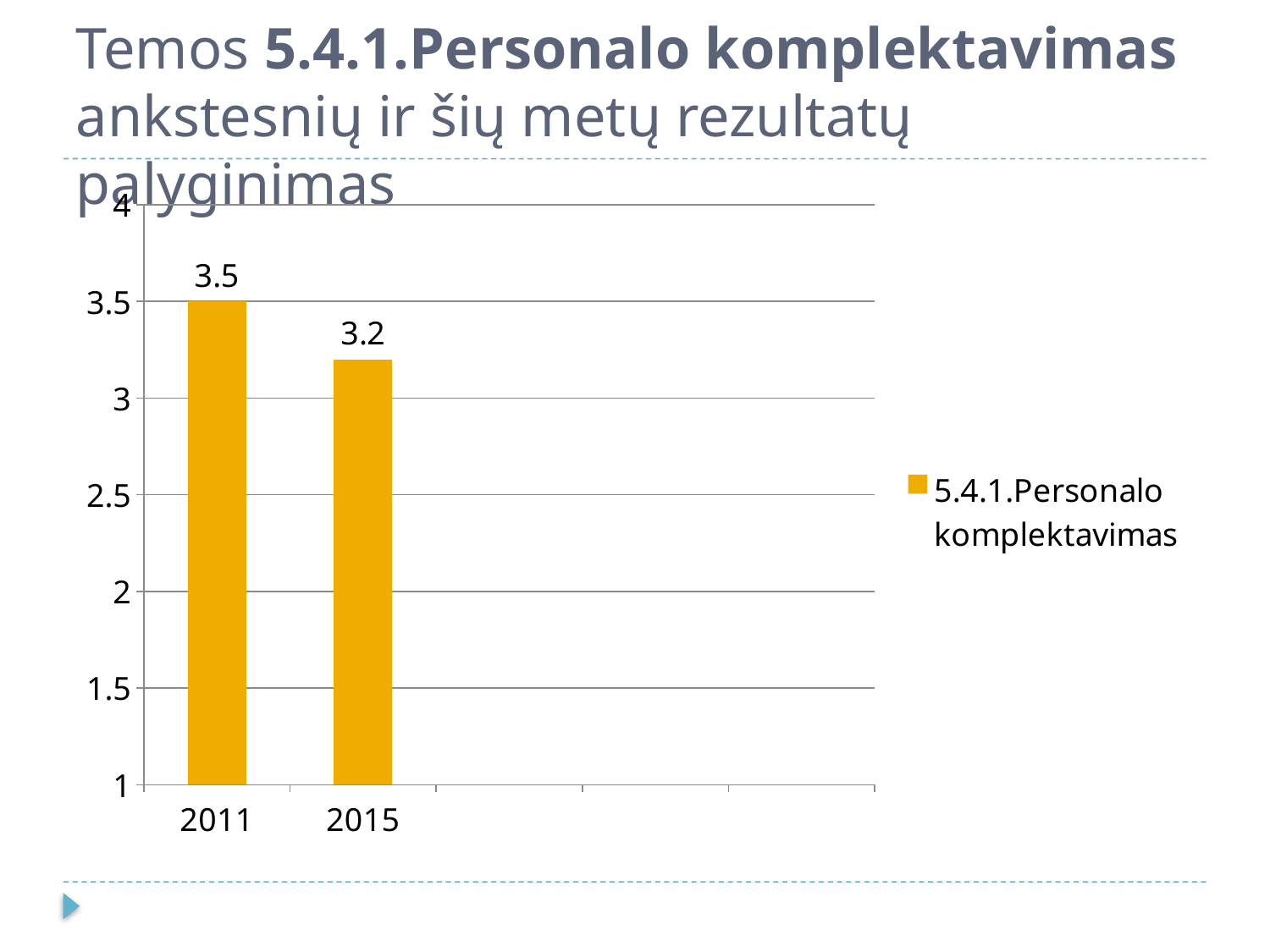
How many series does the legend list? 1 Is the value for 2015 larger or smaller than the value for 2011? smaller What is the value for 2015? 3.2 Do the values rise or fall from 2011 to 2015? fall Is the value for 2011 greater or less than 3? greater How many years are shown on the x axis? 2 What kind of chart is shown? bar chart Which year has the lower value? 2015 Which year has the higher value? 2011 Is the value for 2015 greater or less than 3.5? less What is the value for 2011? 3.5 What is the difference between the 2011 and 2015 values? 0.3